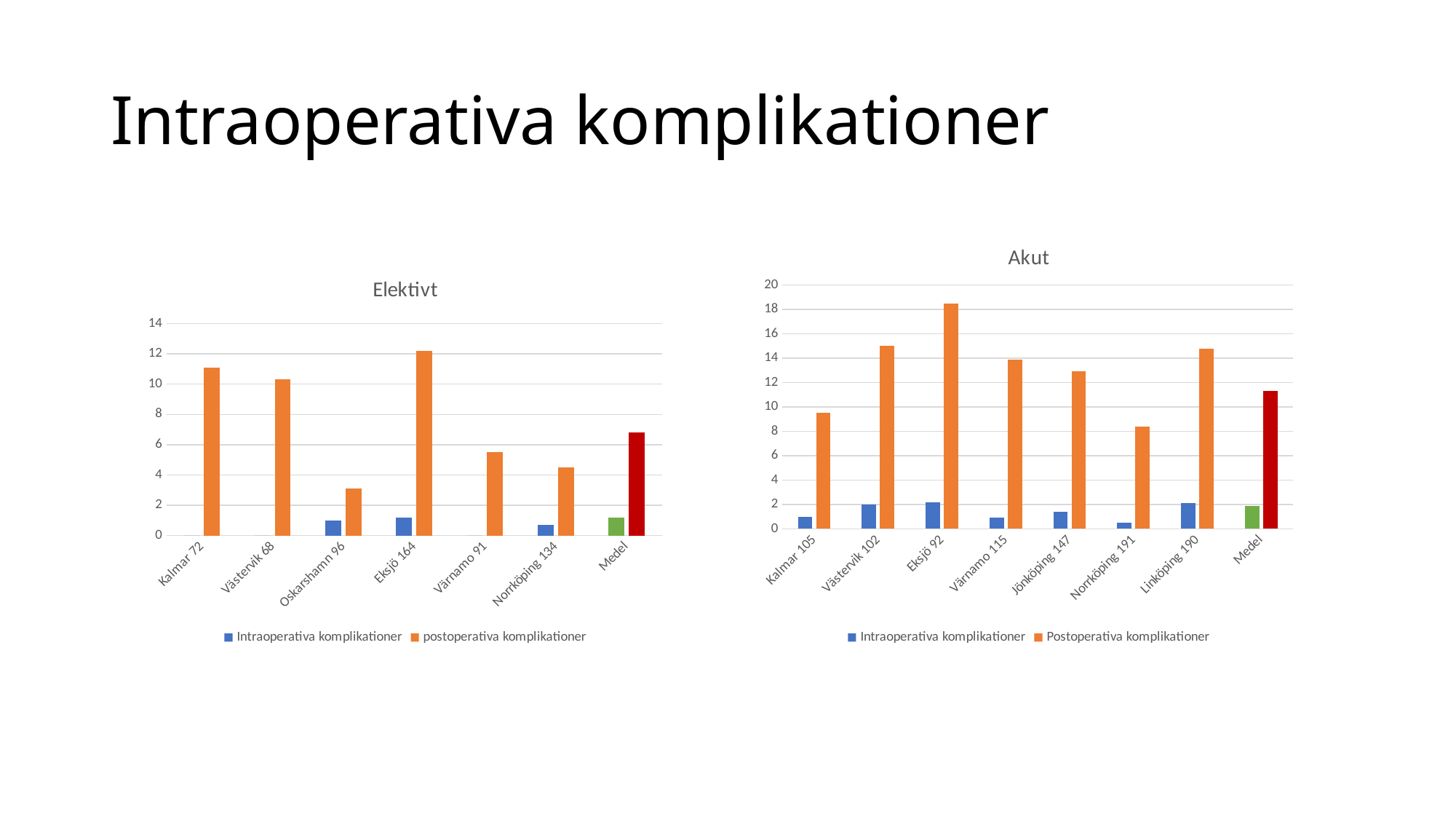
In the Akut chart, which has the larger Postoperativa komplikationer value, Västervik 102 or Värnamo 115? Västervik 102 In the Elektivt chart, is the postoperativa komplikationer value for Kalmar 72 greater or less than 10? greater How many series does the legend of the Akut chart list? 2 In the Akut chart, which category has the highest Postoperativa komplikationer bar? Eksjö 92 In the Elektivt chart, which category has the highest postoperativa komplikationer bar? Eksjö 164 How many categories are shown on the x axis of the Elektivt chart? 7 In the Akut chart, which category has the lowest Postoperativa komplikationer bar? Norrköping 191 In the Akut chart, is the Postoperativa komplikationer value for Eksjö 92 greater or less than 16? greater What is the title of the chart on the right side of the slide? Akut How many categories are shown on the x axis of the Akut chart? 8 In the Elektivt chart, which category has the lowest postoperativa komplikationer bar? Oskarshamn 96 What kind of chart is the Elektivt chart? Bar chart